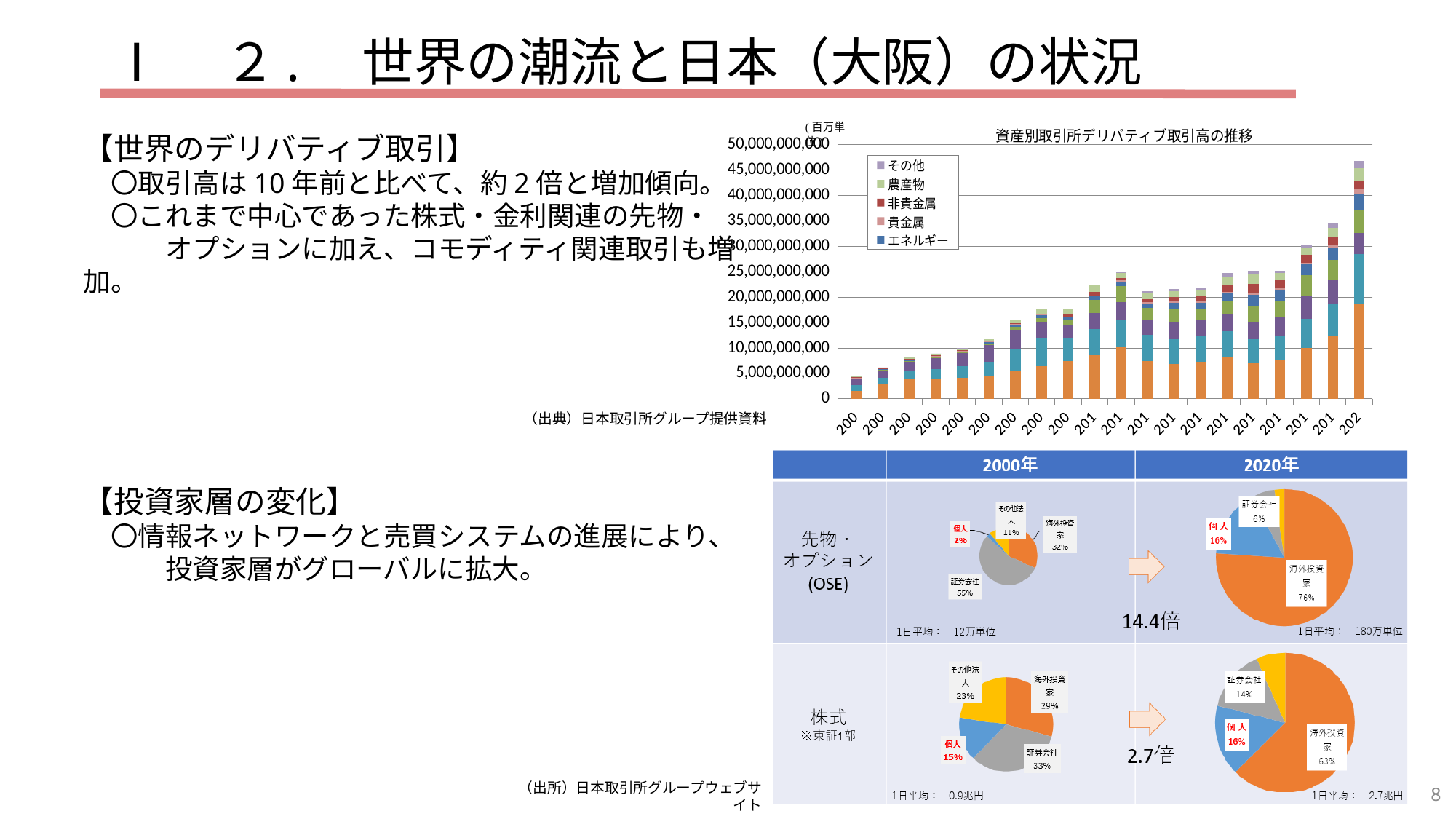
In the 株式 pie chart for 2020年, what share is 個人? 16% In the 株式 pie chart for 2000年, which category has the largest share? 証券会社 In the chart titled 資産別取引所デリバティブ取引高の推移, is the total of the leftmost bar greater or less than 5,000,000,000? less In the chart titled 資産別取引所デリバティブ取引高の推移, is the total of the rightmost bar greater or less than 40,000,000,000? greater In the 先物・オプション (OSE) pie chart for 2000年, which category has the smallest share? 個人 What type of chart is the chart titled 資産別取引所デリバティブ取引高の推移? stacked bar chart In the 先物・オプション (OSE) pie chart for 2000年, what share is 証券会社? 55% In the chart titled 資産別取引所デリバティブ取引高の推移, do the total bar heights generally rise or fall from left to right along the x axis? rise In the chart titled 資産別取引所デリバティブ取引高の推移, how many series does the legend list? 5 By how many percentage points did the 海外投資家 share in the 先物・オプション (OSE) pie chart increase from 2000年 to 2020年? 44 percentage points In the 先物・オプション (OSE) pie chart for 2020年, what share is 海外投資家? 76% In the 株式 pie chart for 2000年, which is larger, the share of 海外投資家 or the share of その他法人? 海外投資家